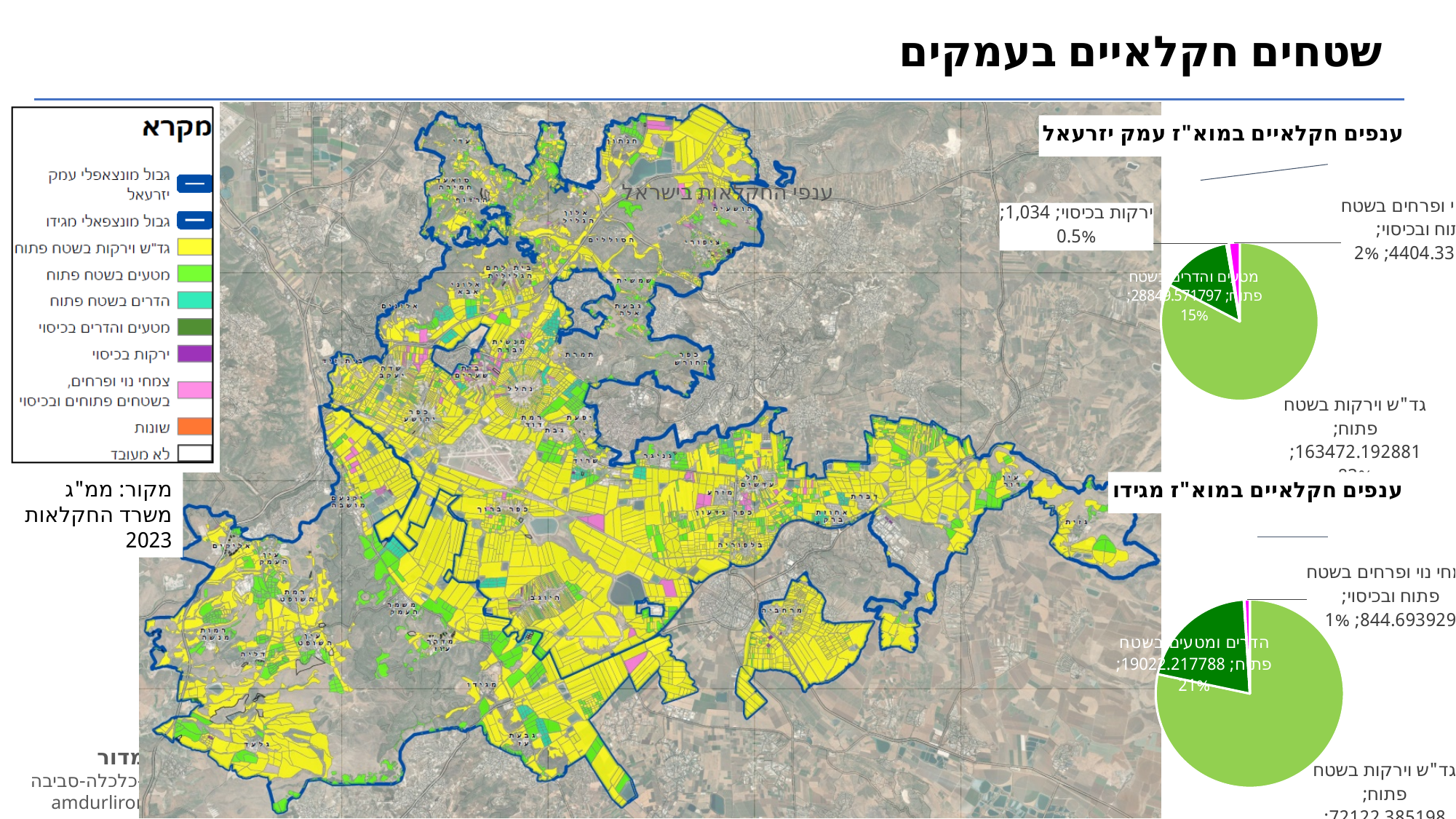
What kind of chart is the chart titled ענפים חקלאיים במוא"ז עמק יזרעאל? pie chart In the chart ענפים חקלאיים במוא"ז עמק יזרעאל, what share of the pie is מטעים והדרים בשטח פתוח? 15% In the chart ענפים חקלאיים במוא"ז עמק יזרעאל, what is the difference in percentage points between the share of מטעים והדרים בשטח פתוח and the share of ירקות בכיסוי? 14.5% In the chart ענפים חקלאיים במוא"ז עמק יזרעאל, which category has the largest slice? גד"ש וירקות בשטח פתוח In the chart ענפים חקלאיים במוא"ז עמק יזרעאל, what is the value for מטעים והדרים בשטח פתוח? 28849.571797 In the chart ענפים חקלאיים במוא"ז מגידו, which category has the largest slice? גד"ש וירקות בשטח פתוח In the chart ענפים חקלאיים במוא"ז מגידו, what is the value for צמחי נוי ופרחים בשטח פתוח ובכיסוי? 844.693929 In the chart ענפים חקלאיים במוא"ז עמק יזרעאל, what share of the pie is ירקות בכיסוי? 0.5% In the chart ענפים חקלאיים במוא"ז עמק יזרעאל, what is the value for גד"ש וירקות בשטח פתוח? 163472.192881 In the chart ענפים חקלאיים במוא"ז מגידו, what share of the pie is הדרים ומטעים בשטח פתוח? 21%